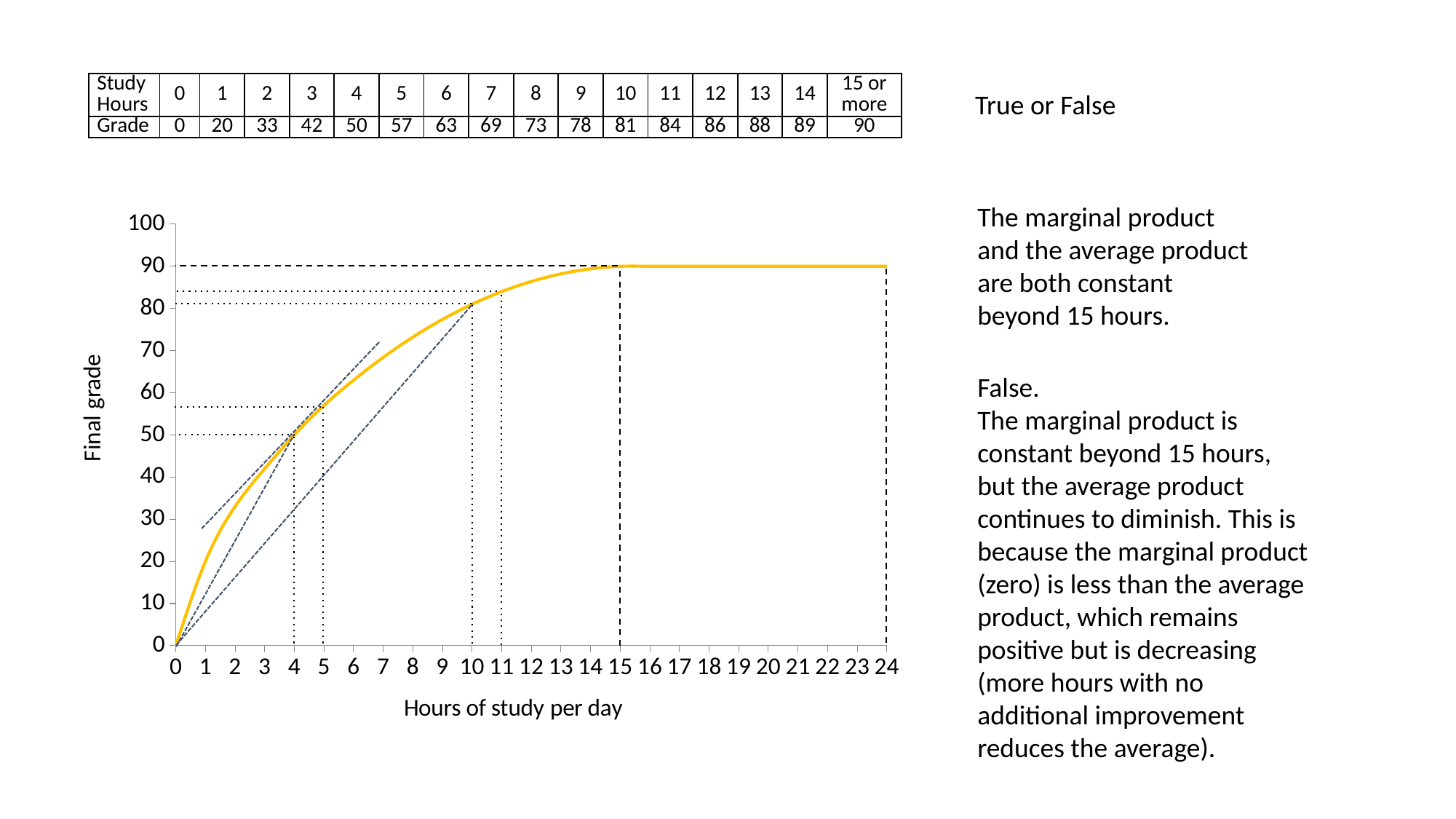
What is the highest final grade reached on the chart? 90 How does the final grade change as hours of study per day increase along the x axis? It rises, then flattens at 90 from 15 hours onward What is the title of the y axis of the chart? Final grade What is the difference in final grade between 10 hours and 4 hours of study per day? 31 What type of chart is shown on the slide? Line chart Which gives a higher final grade: 5 hours or 11 hours of study per day? 11 hours What is the title of the x axis of the chart? Hours of study per day What is the final grade for 4 hours of study per day? 50 What is the final grade for 15 or more hours of study per day? 90 Is the final grade for 7 hours of study per day greater or less than 60? greater Is the final grade for 2 hours of study per day greater or less than 40? less What is the final grade for 10 hours of study per day? 81